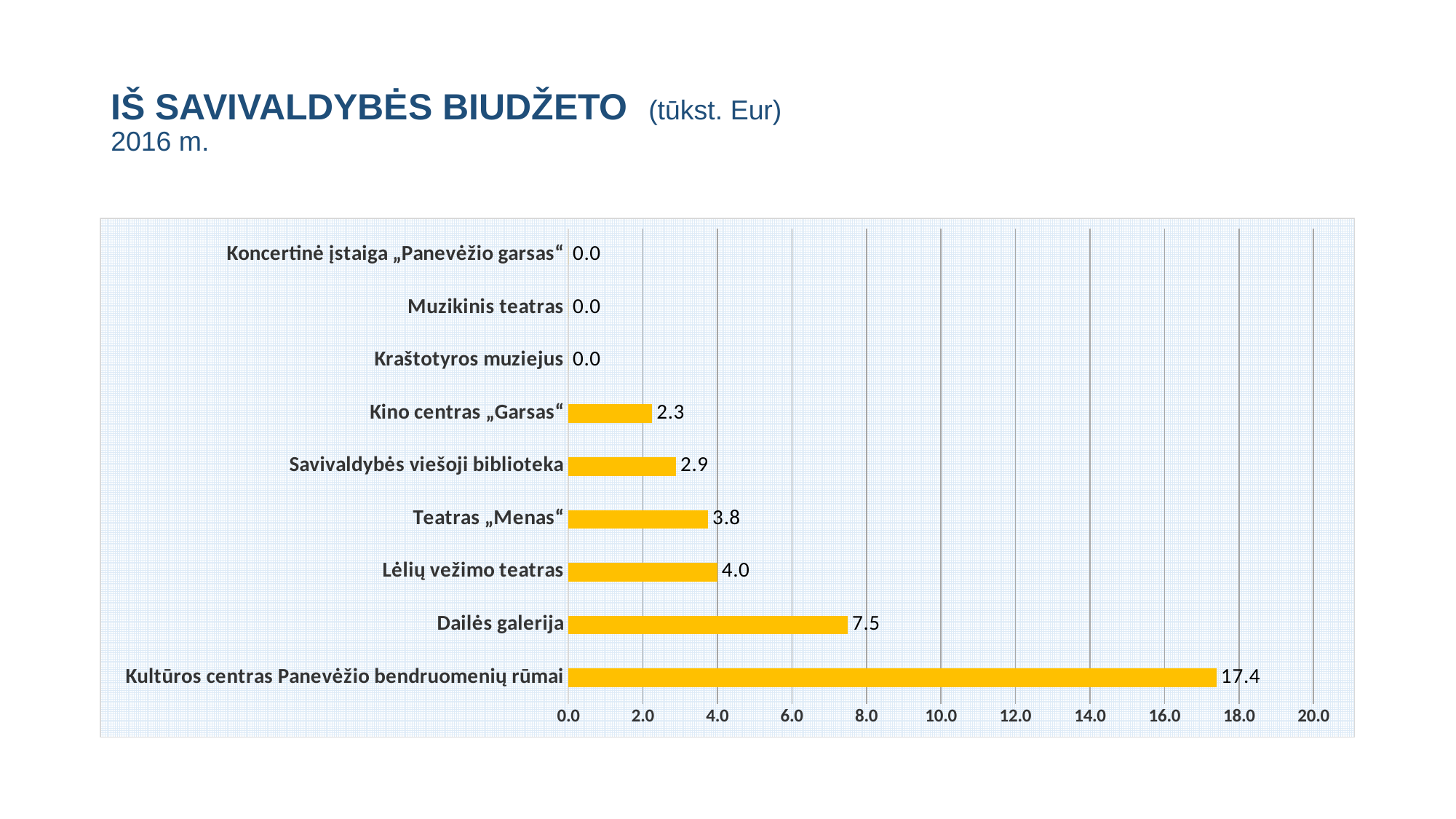
What year does the chart title refer to? 2016 m. What is the difference between the values for Lėlių vežimo teatras and Teatras „Menas“? 0.2 How many categories are shown in the chart? 9 What is the value for Kino centras „Garsas“? 2.3 Is the value for Kultūros centras Panevėžio bendruomenių rūmai greater or less than 16.0? greater Which category has the highest value? Kultūros centras Panevėžio bendruomenių rūmai What is the value for Savivaldybės viešoji biblioteka? 2.9 Which is larger, the value for Dailės galerija or the value for Lėlių vežimo teatras? Dailės galerija How many categories have a value of 0.0? 3 What kind of chart is shown on the slide? bar chart What is the value for Dailės galerija? 7.5 What is the difference between the values for Kultūros centras Panevėžio bendruomenių rūmai and Dailės galerija? 9.9